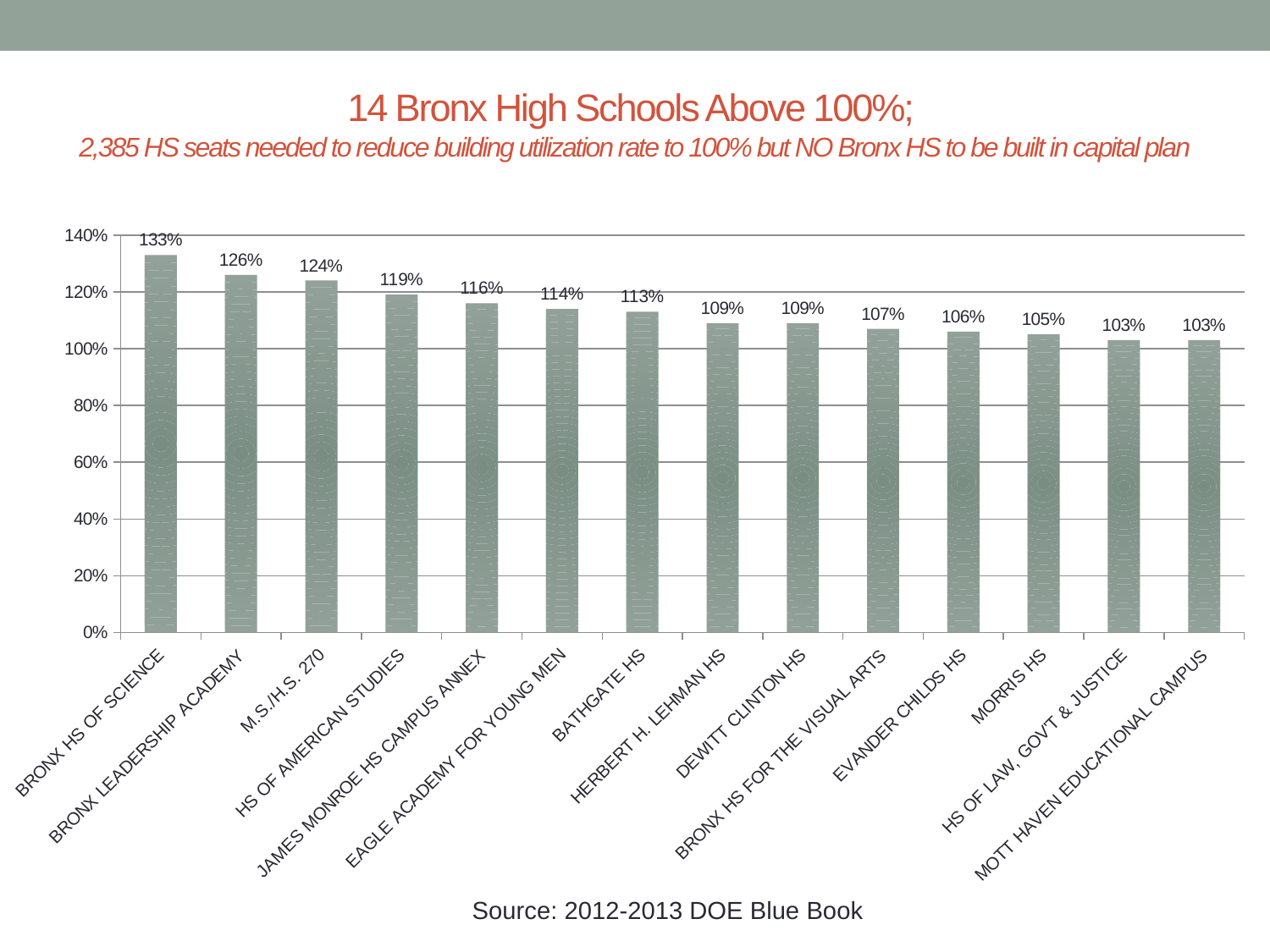
Which school has the highest utilization rate on the chart? Bronx HS of Science Do the values rise or fall from left to right across the chart? Fall How many schools are shown on the chart? 14 What kind of chart is shown on the slide? Bar chart What is the value shown for Morris HS? 105% Which is larger, the value for HS of American Studies or the value for Bathgate HS? HS of American Studies What is the difference between the values for Bronx Leadership Academy and M.S./H.S. 270? 2% What is the difference between the values for Bronx HS of Science and Mott Haven Educational Campus? 30% What is the value shown for Herbert H. Lehman HS? 109% What source is cited below the chart? 2012-2013 DOE Blue Book Is the value for Eagle Academy for Young Men greater or less than 100%? greater What is the utilization rate shown for Bronx HS of Science? 133%